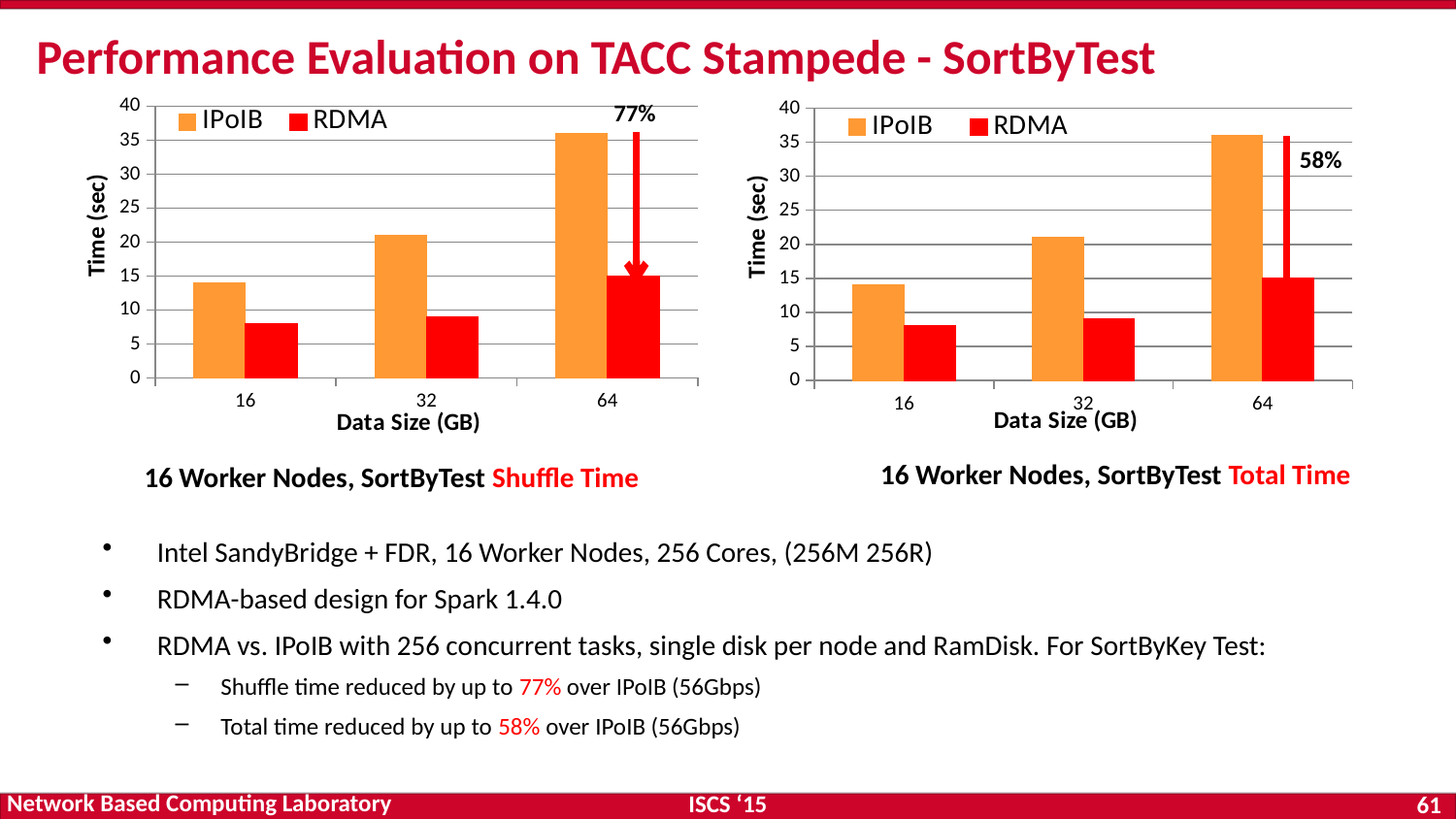
In the left chart (SortByTest Shuffle Time), which data size has the highest IPoIB time? 64 In the left chart (SortByTest Shuffle Time), how many series does the legend list? 2 In the left chart (SortByTest Shuffle Time), do the IPoIB values rise or fall as data size increases? rise In the left chart (SortByTest Shuffle Time), is the IPoIB value for 32 GB greater or less than 20? greater In the right chart (SortByTest Total Time), how many data size categories are shown on the x axis? 3 In the right chart (SortByTest Total Time), is the RDMA value for 16 GB greater or less than 10? less In the left chart (SortByTest Shuffle Time), is the IPoIB value for 64 GB greater or less than 30? greater What percentage reduction is annotated on the left chart (SortByTest Shuffle Time)? 77% In the right chart (SortByTest Total Time), which data size has the lowest RDMA time? 16 In the right chart (SortByTest Total Time), which is larger at 64 GB, IPoIB or RDMA? IPoIB In the left chart (SortByTest Shuffle Time), what type of chart is shown? bar chart What is the y-axis label of the right chart (SortByTest Total Time)? Time (sec)